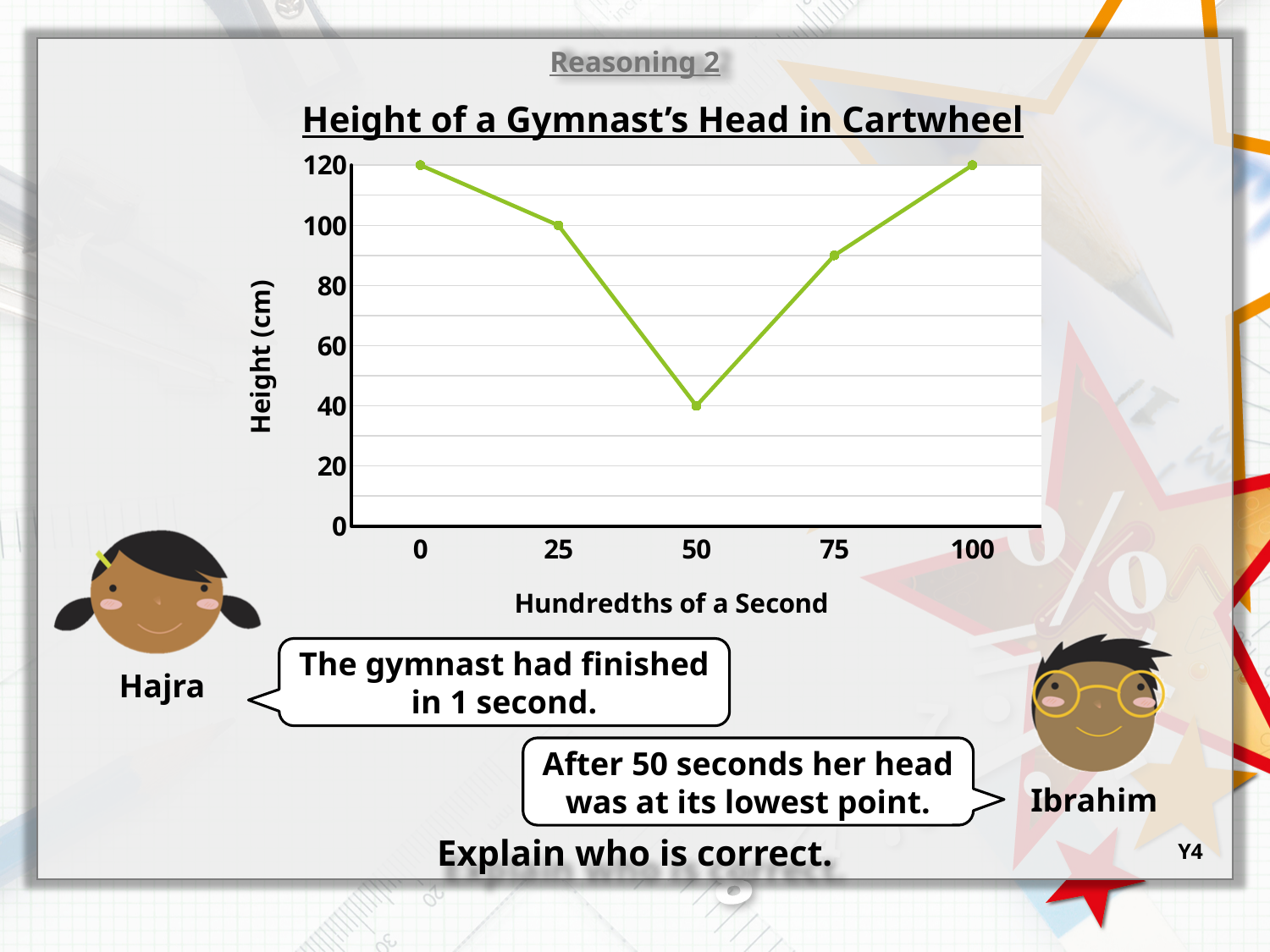
What is the height at 25 hundredths of a second? 100 What is the height at 100 hundredths of a second? 120 At which time (in hundredths of a second) is the height lowest? 50 What kind of chart is shown? line chart Is the height at 75 hundredths of a second greater or less than 80? greater How many data points are plotted on the chart? 5 What is the difference in height between 0 and 50 hundredths of a second? 80 What is the label on the vertical axis? Height (cm) What is the height at 0 hundredths of a second? 120 Which has the greater height: 25 or 50 hundredths of a second? 25 What is the height at 50 hundredths of a second? 40 Does the height rise or fall between 0 and 50 hundredths of a second? fall